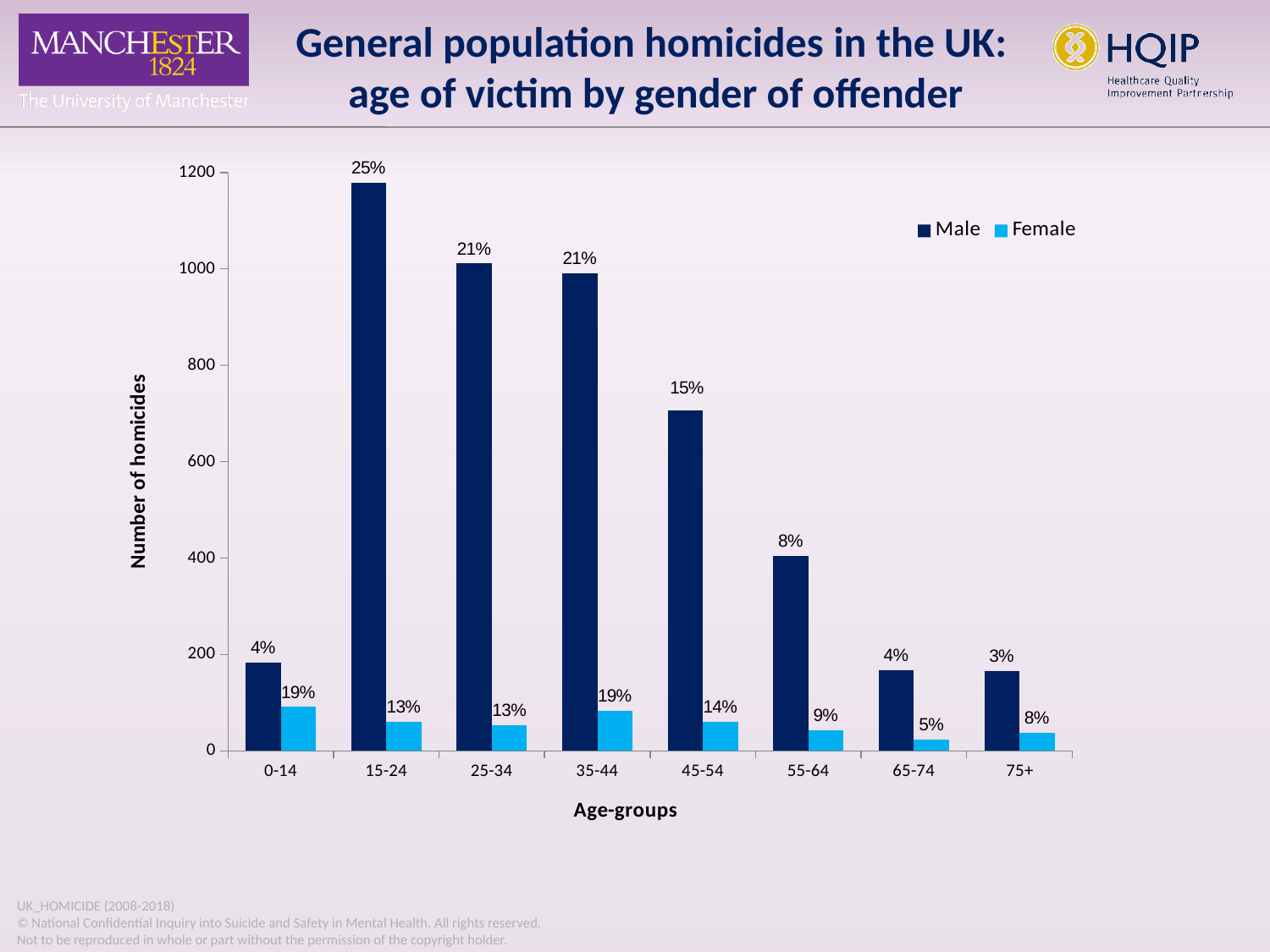
What percentage label is shown on the Male bar for the 15-24 age-group? 25% What kind of chart is shown on the slide? bar chart Which age-group has the lowest Female bar? 65-74 Do the Male bars rise or fall from the 15-24 age-group to the 75+ age-group? fall Is the Male value for the 45-54 age-group greater or less than 600? greater What percentage label is shown on the Female bar for the 0-14 age-group? 19% What is the title of the y axis? Number of homicides In the 0-14 age-group, which is larger, the Male bar or the Female bar? Male Is the Female value for the 35-44 age-group greater or less than 200? less Which age-group has the highest Male bar? 15-24 How many age-groups are shown on the x axis? 8 How many series does the legend list? 2